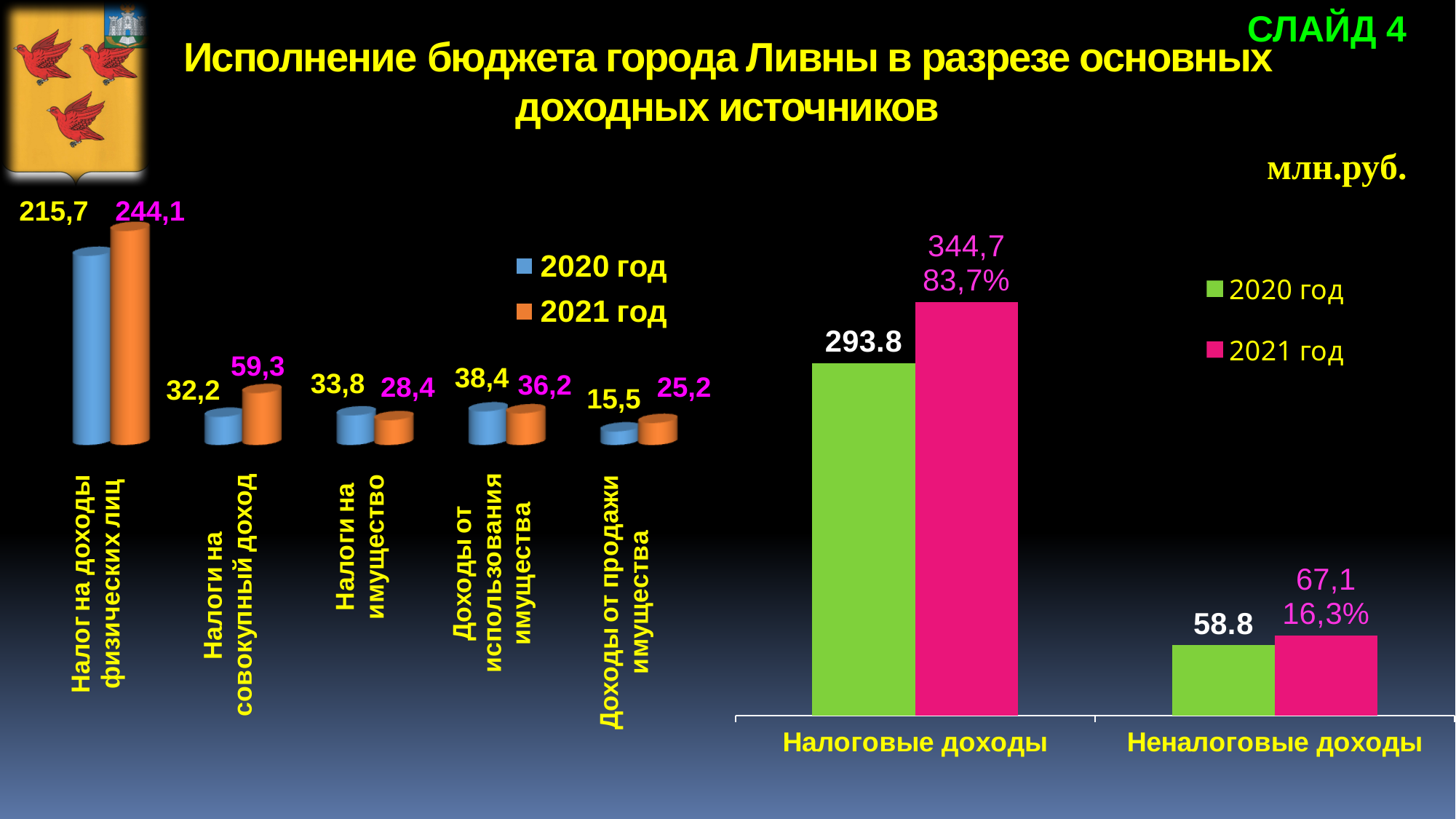
In the right chart, what is the difference between the 2021 год and 2020 год values for Налоговые доходы? 50,9 In the left chart, is the 2020 год or the 2021 год value larger for Налоги на имущество? 2020 год How many categories are shown in the left chart? 5 In the right chart, what is the 2021 год value for Налоговые доходы? 344,7 In the left chart, which category has the lowest 2021 год value? Доходы от продажи имущества In the left chart, which category has the highest 2020 год value? Налог на доходы физических лиц In the left chart, what is the difference between the 2021 год and 2020 год values for Налог на доходы физических лиц? 28,4 How many series does the legend of the left chart list? 2 In the left chart, what is the 2020 год value for Налоги на совокупный доход? 32,2 In the left chart, what is the 2021 год value for Налог на доходы физических лиц? 244,1 In the right chart, what is the 2020 год value for Неналоговые доходы? 58.8 What type of chart is the right chart? Bar chart